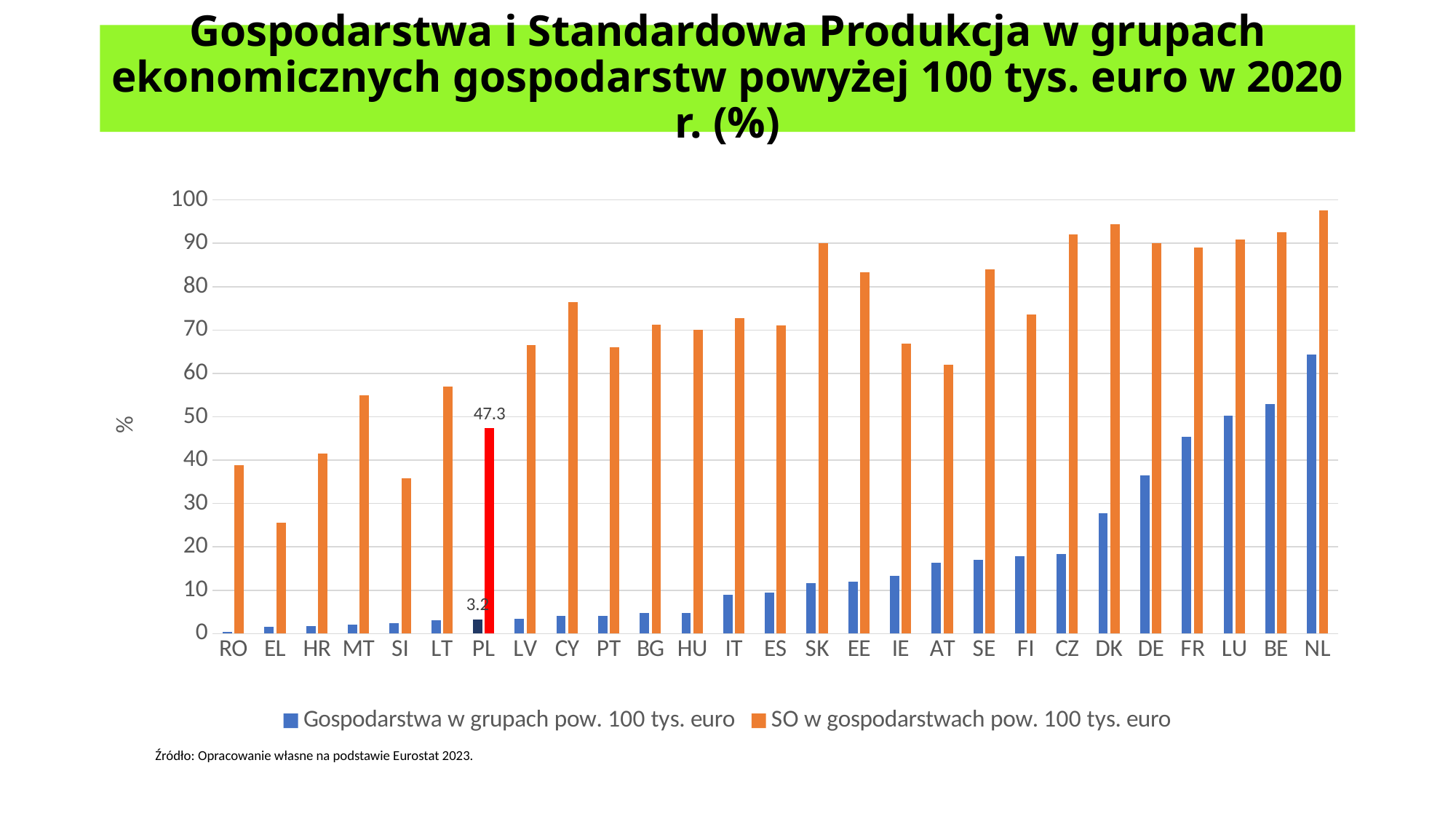
How many series does the legend list? 2 Which country has the lowest value for 'SO w gospodarstwach pow. 100 tys. euro'? EL What type of chart is shown on the slide? bar chart Is the 'SO w gospodarstwach pow. 100 tys. euro' value for SK greater or less than 80? greater Which has the larger 'SO w gospodarstwach pow. 100 tys. euro' value, CY or PT? CY What is the value of 'Gospodarstwa w grupach pow. 100 tys. euro' for PL? 3.2 Which country has the highest value for 'Gospodarstwa w grupach pow. 100 tys. euro'? NL How many countries are shown on the x axis? 27 Is the 'Gospodarstwa w grupach pow. 100 tys. euro' value for DE greater or less than 40? less What is the value of 'SO w gospodarstwach pow. 100 tys. euro' for PL? 47.3 Which country has the highest value for 'SO w gospodarstwach pow. 100 tys. euro'? NL What is the difference between the SO value and the Gospodarstwa value for PL? 44.1